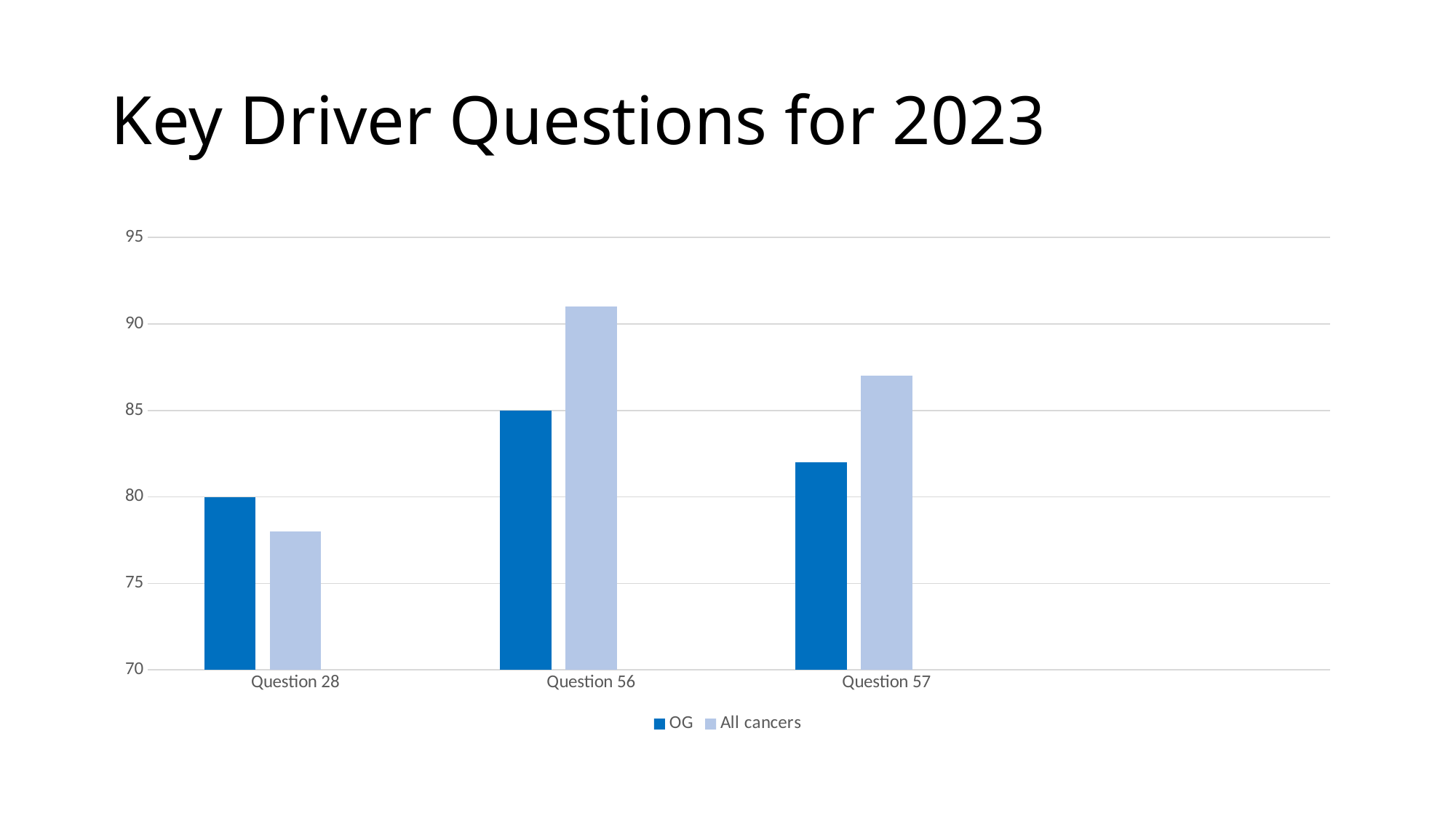
What is the title of the chart slide? Key Driver Questions for 2023 How many question categories are shown on the x axis? 3 Is the All cancers value for Question 56 greater or less than 90? greater What is the OG value for Question 56? 85 Is the All cancers value for Question 28 greater or less than 80? less Is the All cancers value for Question 57 greater or less than 85? greater Which question has the lowest OG value? Question 28 For Question 57, which is larger, the OG value or the All cancers value? All cancers How many series does the legend list? 2 What is the OG value for Question 28? 80 What type of chart is shown on the slide? bar chart Which question has the highest All cancers value? Question 56